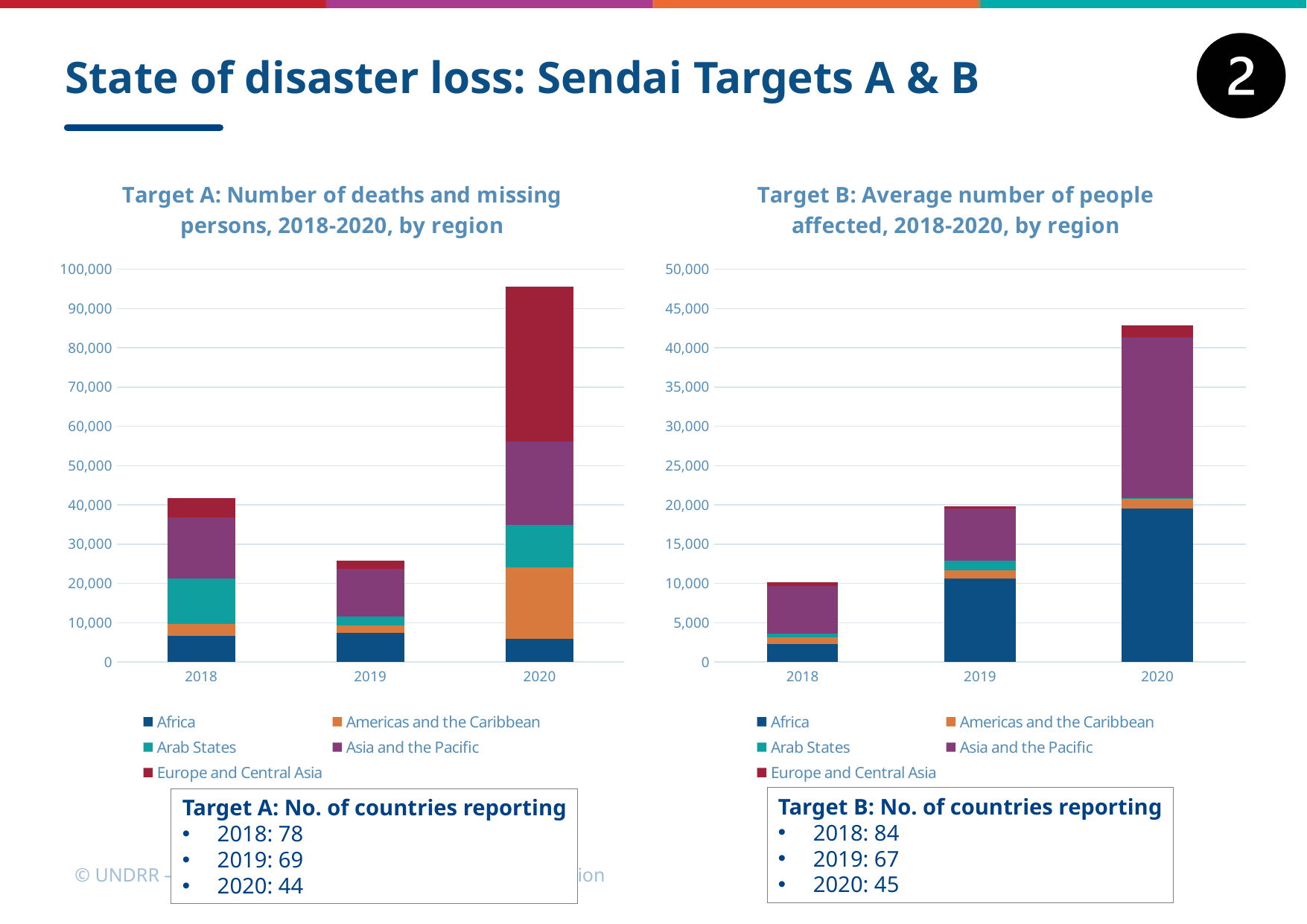
What kind of chart is the Target A chart on the left? Stacked bar chart In the Target B chart, do the total bar heights rise or fall from 2018 to 2020? rise In the Target B chart, which year has the lowest total average number of people affected? 2018 In the Target B chart, is the total for 2018 greater or less than 15,000? less In the Target B chart, which year has the highest total average number of people affected? 2020 In the Target A chart, which year has the lowest total number of deaths and missing persons? 2019 In the Target A chart, is the total for 2020 greater or less than 90,000? greater How many series does the legend of the Target A chart list? 5 In the Target A chart, which year has the larger total: 2018 or 2019? 2018 How many years are shown on the x axis of the Target B chart? 3 Which region is shown in dark blue at the bottom of the bars in both charts? Africa In the Target A chart, which year has the highest total number of deaths and missing persons? 2020